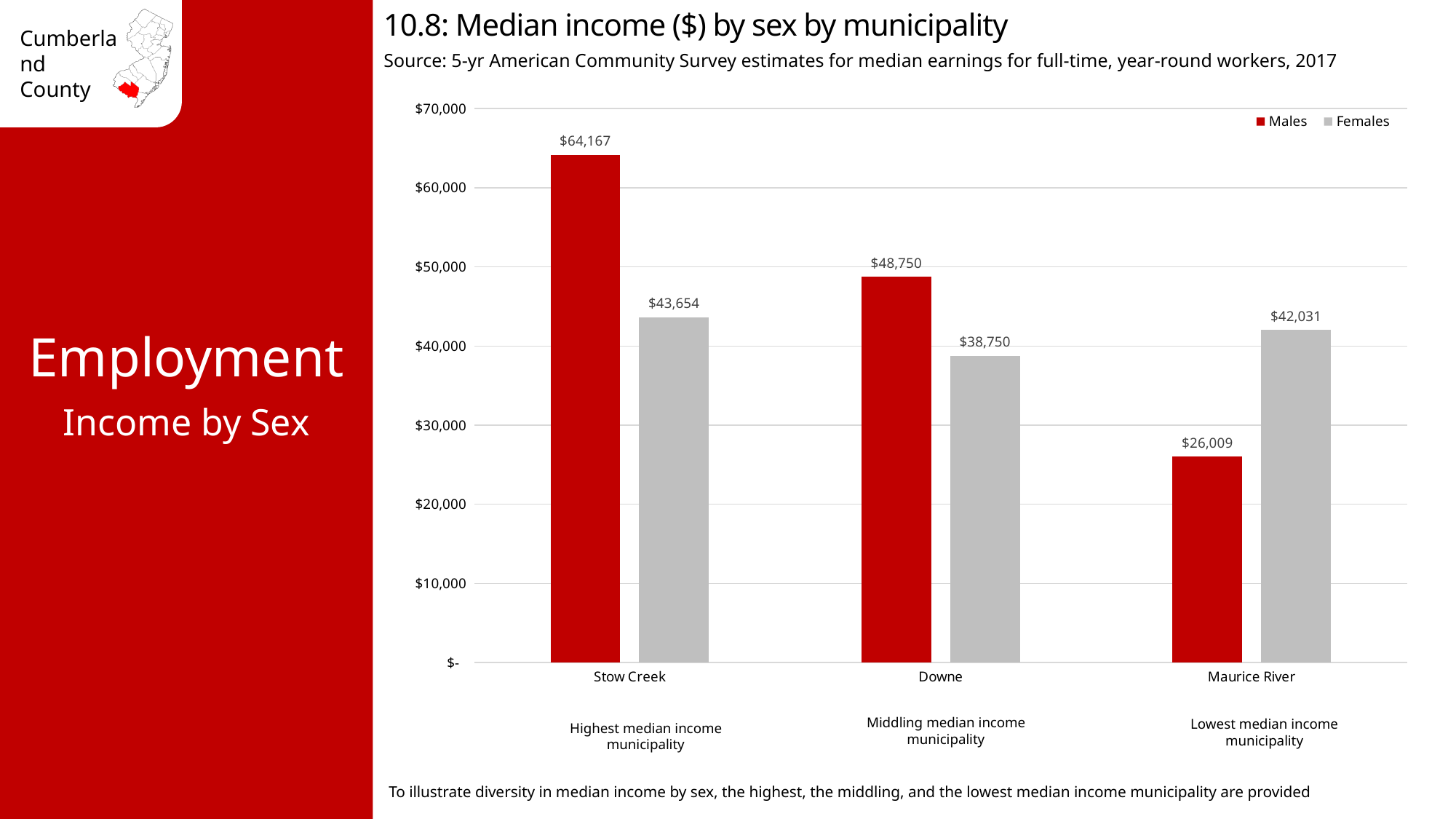
How many series does the legend list? 2 What is the median income for females in Downe? $38,750 What kind of chart is shown on the slide? Bar chart What is the difference between female and male median income in Maurice River? $16,022 Is the median income for males in Downe greater or less than $40,000? greater Which municipality has the highest median income for males? Stow Creek What is the difference between male and female median income in Stow Creek? $20,513 In Maurice River, which is larger: the median income for males or for females? Females What is the median income for males in Stow Creek? $64,167 How many municipalities are shown on the chart? 3 What is the median income for females in Maurice River? $42,031 Which municipality has the lowest median income for females? Downe